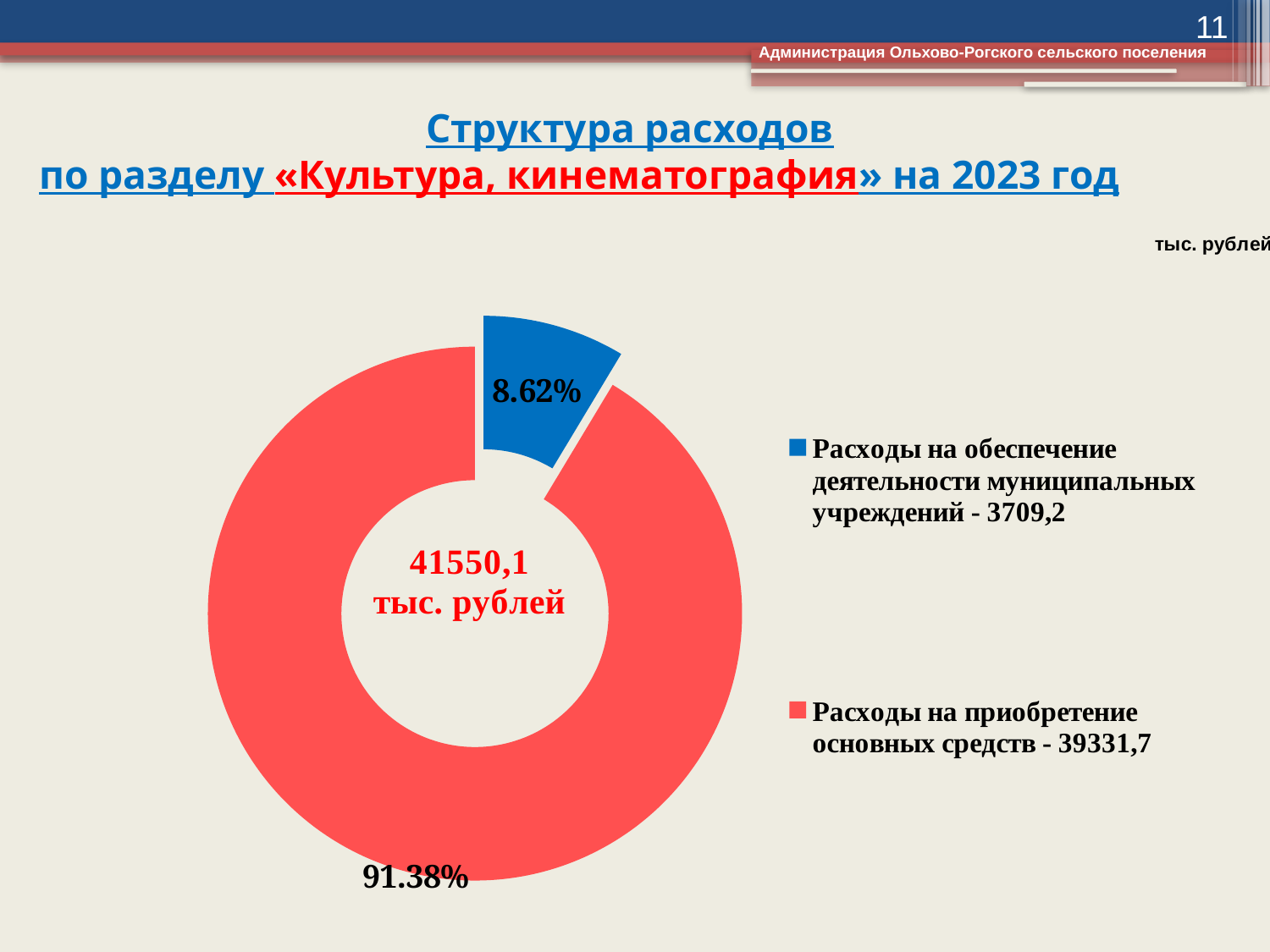
What value is given in the legend for Расходы на обеспечение деятельности муниципальных учреждений? 3709,2 How many slices does the chart have? 2 What value is given in the legend for Расходы на приобретение основных средств? 39331,7 What kind of chart is shown on the slide? Pie (doughnut) chart Which category has the largest share of the chart? Расходы на приобретение основных средств What is the difference between Расходы на приобретение основных средств (39331,7) and Расходы на обеспечение деятельности муниципальных учреждений (3709,2)? 35622,5 Which is larger: Расходы на приобретение основных средств or Расходы на обеспечение деятельности муниципальных учреждений? Расходы на приобретение основных средств How many entries does the legend list? 2 What share of the chart is labelled for the red slice (Расходы на приобретение основных средств)? 91.38% Which category has the smallest share of the chart? Расходы на обеспечение деятельности муниципальных учреждений What share of the chart is labelled for the blue slice (Расходы на обеспечение деятельности муниципальных учреждений)? 8.62% What total amount is shown in the centre of the chart? 41550,1 тыс. рублей